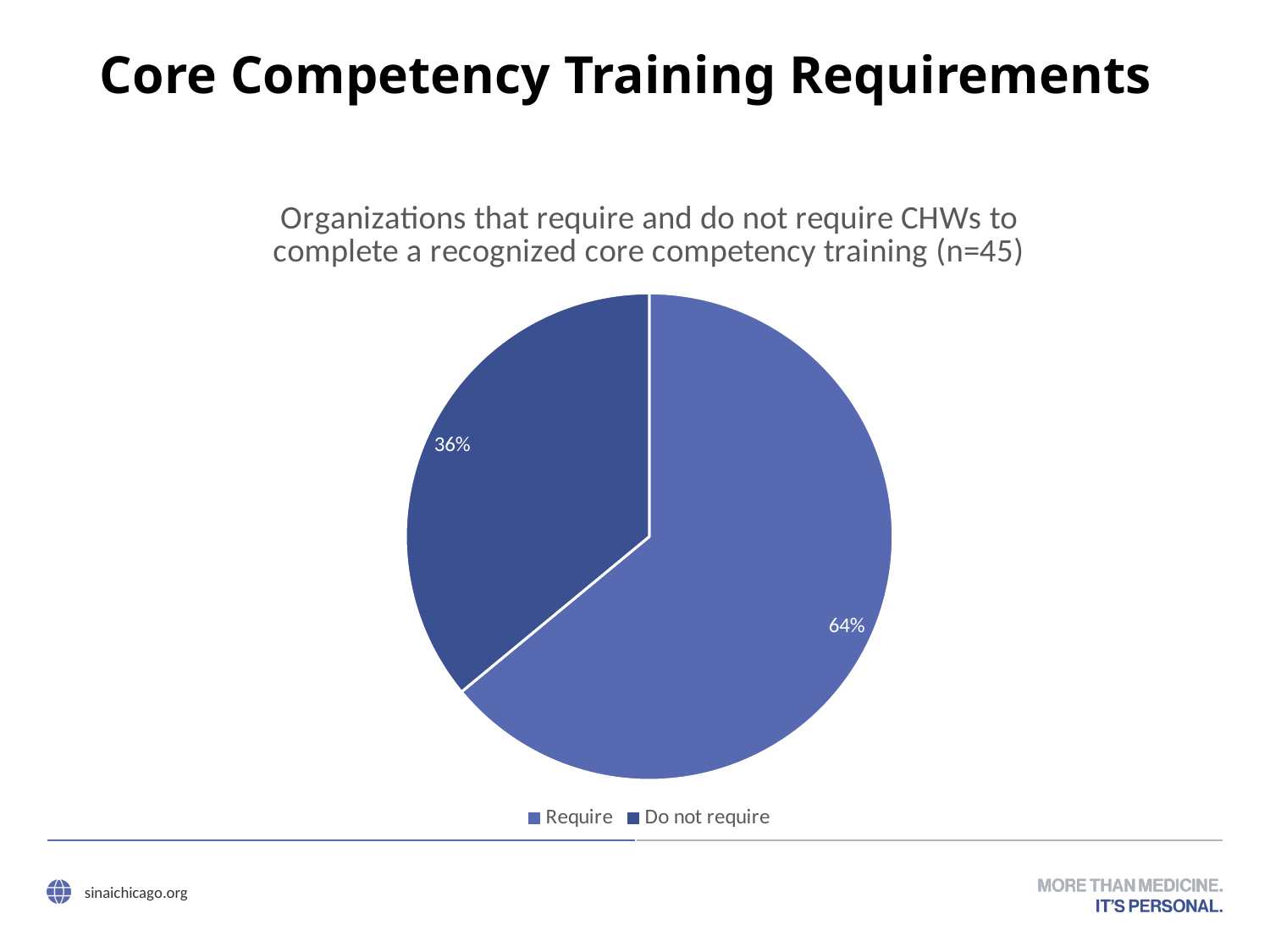
What percentage of organizations do not require CHWs to complete a recognized core competency training? 36% What kind of chart is shown on the slide? pie chart Which category has the smaller share of the pie? Do not require How many slices does the pie chart have? 2 Which legend entry is shown in the darker blue colour? Do not require What is the difference in percentage points between the Require and Do not require slices? 28 What is the sample size (n) stated in the chart title? 45 What share of the pie does the Do not require slice represent? 36% Is the share for Require larger or smaller than the share for Do not require? larger Which category has the larger share of the pie? Require How many entries does the legend list? 2 What percentage of organizations require CHWs to complete a recognized core competency training? 64%